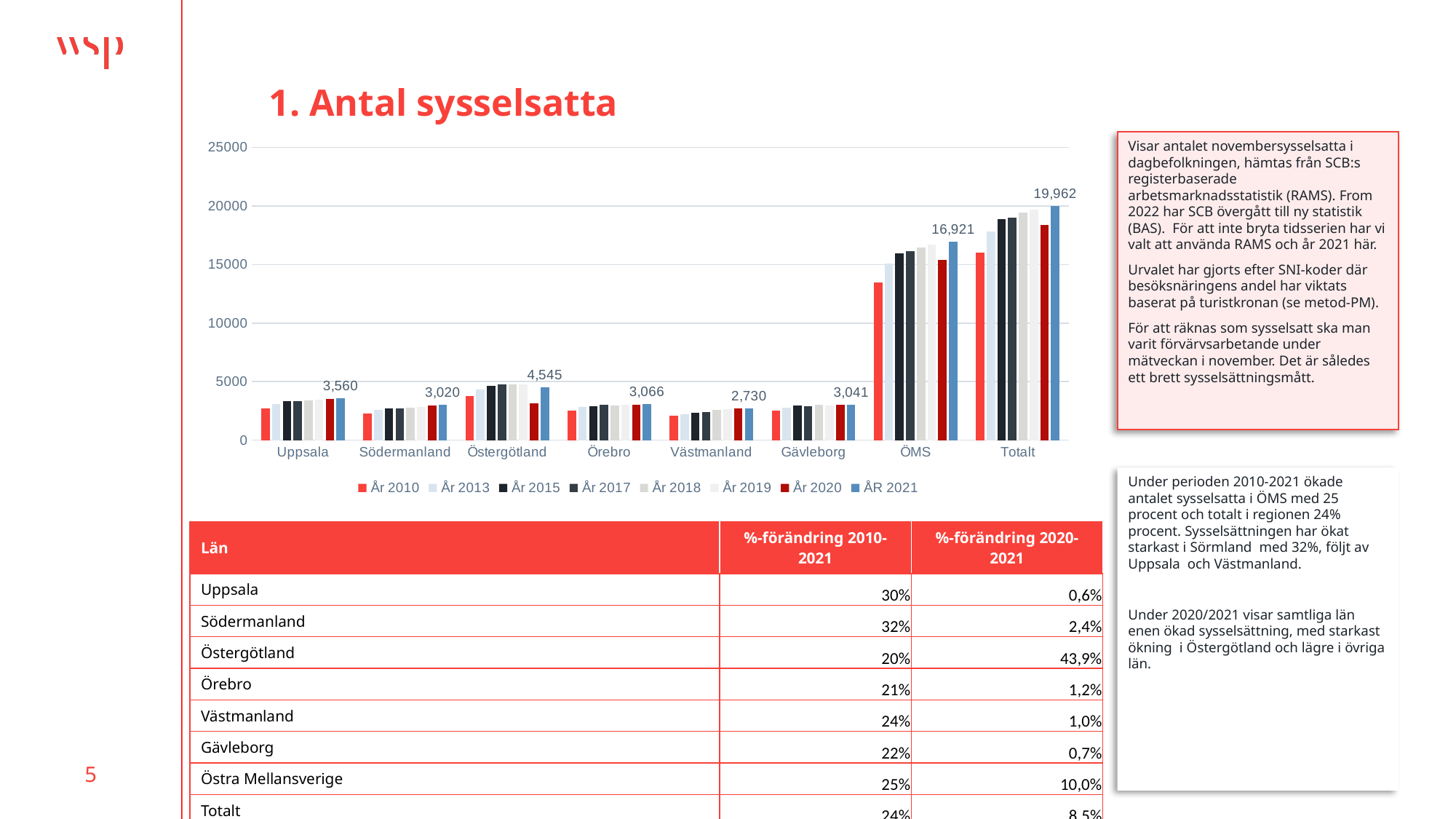
What is the difference between the ÅR 2021 values for Uppsala and Södermanland? 540 Among the labelled ÅR 2021 values, which category has the lowest value? Västmanland How many series does the chart legend list? 8 Which has the larger ÅR 2021 value, Östergötland or Örebro? Östergötland What is the ÅR 2021 value for Uppsala? 3,560 What is the ÅR 2021 value for Totalt? 19,962 Among the labelled ÅR 2021 values, which category has the highest value? Totalt What kind of chart is shown on the slide? bar chart Is the År 2010 value for ÖMS greater or less than 15000? less How many categories are shown on the x axis of the chart? 8 What is the ÅR 2021 value for ÖMS? 16,921 What is the ÅR 2021 value for Östergötland? 4,545